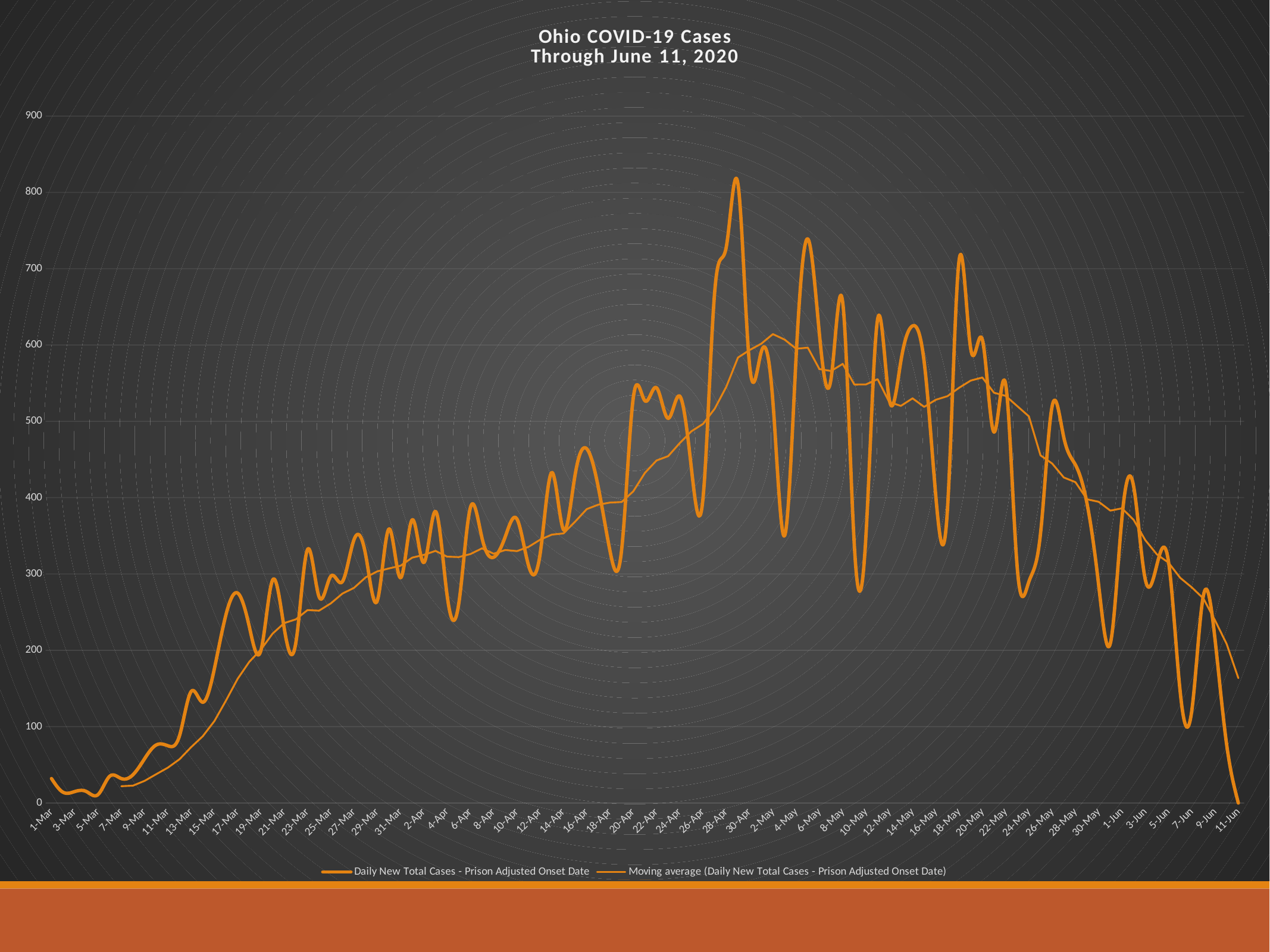
What is the title of the chart? Ohio COVID-19 Cases Through June 11, 2020 Is the value of Daily New Total Cases on 1-Mar greater or less than 100? less Is the moving average on 2-May greater or less than 500? greater Does the moving average rise or fall between 1-Mar and 17-Mar? rise In which month does the highest peak of Daily New Total Cases occur? April How many series does the legend list? 2 What is the first date shown on the x axis? 1-Mar Is the highest peak of Daily New Total Cases greater or less than 700? greater Which is larger, the moving average on 2-May or the moving average on 11-Jun? 2-May What kind of chart is shown on the slide? line chart